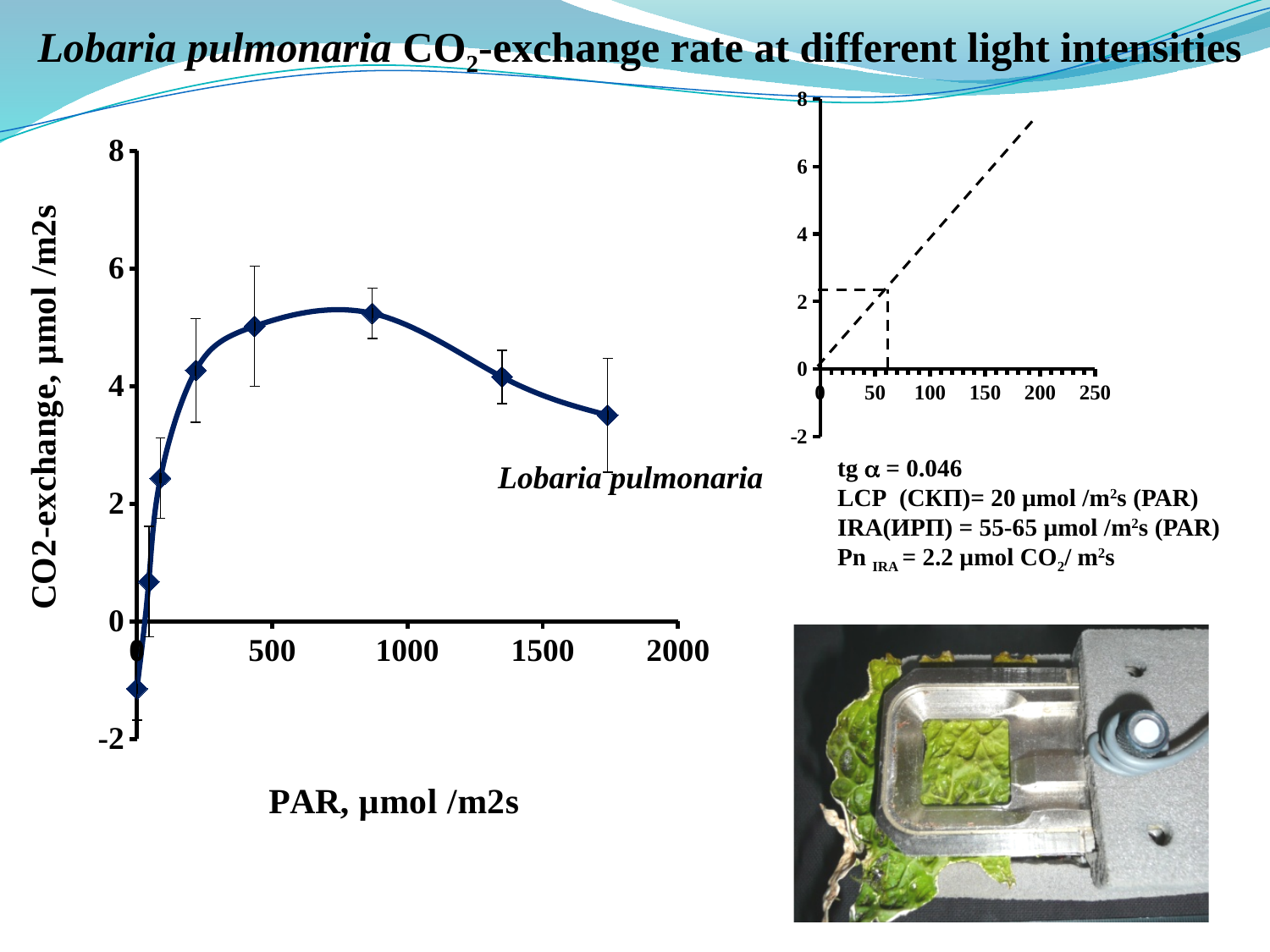
On the small inset chart at the top right, what is the highest value shown on the x axis? 250 On the large chart on the left, which is larger: the CO2-exchange value at the point near PAR 870 or at the point near PAR 1750? the point near PAR 870 On the large chart on the left, does the CO2-exchange rate rise or fall as PAR increases from 1000 to 2000? fall On the large chart on the left, is the CO2-exchange value at the lowest PAR (near 0) greater or less than 0? less On the large chart on the left, is the CO2-exchange value at the last point (PAR near 1750) greater or less than 4? less On the large chart on the left, what is the highest value shown on the y axis? 8 On the large chart on the left, what is the label of the x axis? PAR, µmol /m2s On the large chart on the left, what is the label of the y axis? CO2-exchange, µmol /m2s On the large chart on the left, is the CO2-exchange value at the point near PAR 870 greater or less than 4? greater What kind of chart is the large chart on the left of the slide? line chart On the large chart on the left, does the CO2-exchange rate rise or fall as PAR increases from 0 to 500? rise On the large chart on the left, what is the highest value shown on the x axis? 2000